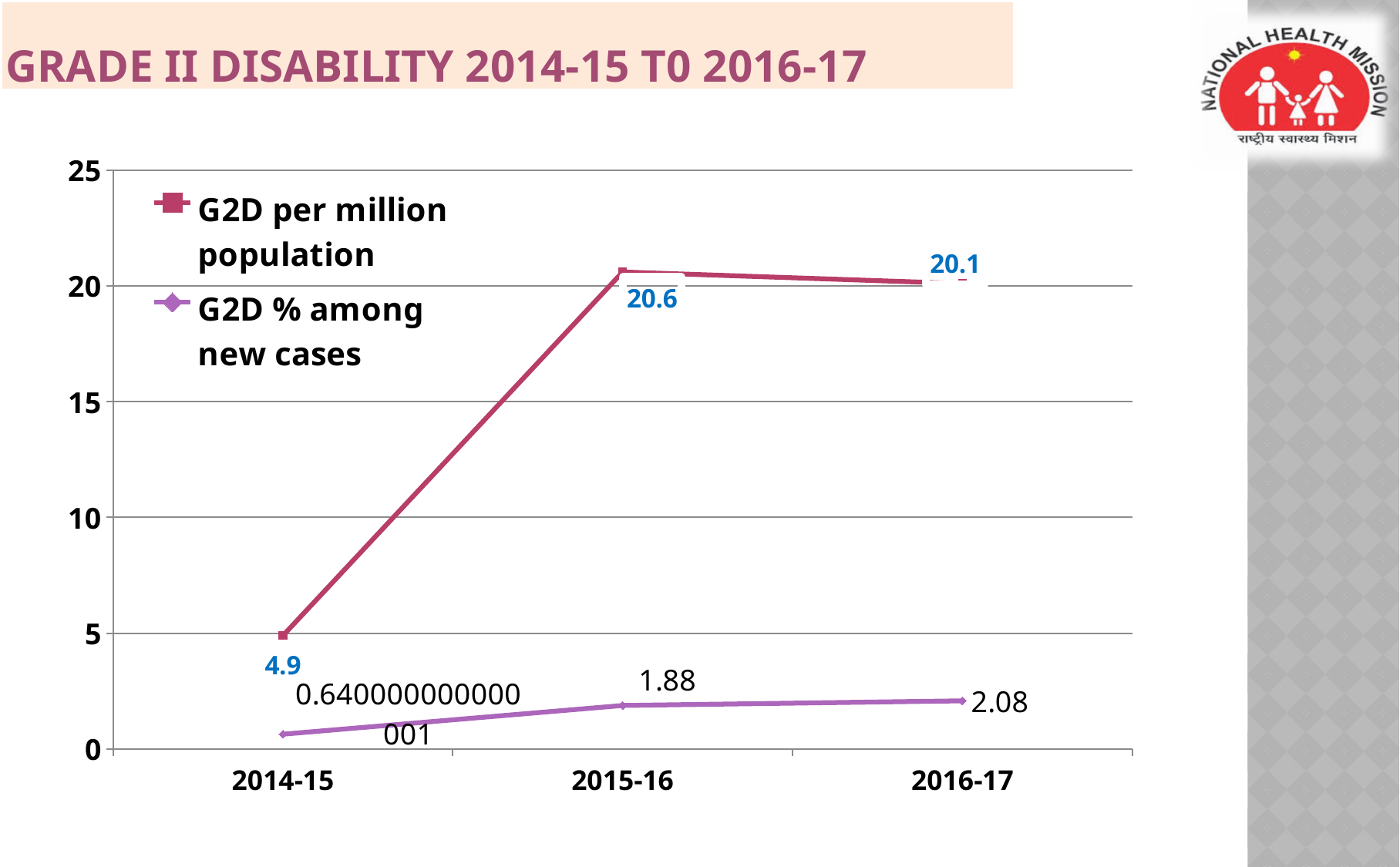
Is the G2D % among new cases value for 2014-15 greater or less than 5? less What is the G2D % among new cases value for 2015-16? 1.88 What kind of chart is shown on the slide? line chart What is the G2D % among new cases value for 2016-17? 2.08 In which year is G2D per million population lowest? 2014-15 What is the G2D per million population value for 2016-17? 20.1 What is the G2D per million population value for 2014-15? 4.9 How many series does the legend list? 2 What is the G2D per million population value for 2015-16? 20.6 What is the difference between the G2D per million population values for 2015-16 and 2014-15? 15.7 In which year is G2D per million population highest? 2015-16 Which is larger, the G2D % among new cases value for 2016-17 or for 2015-16? 2016-17